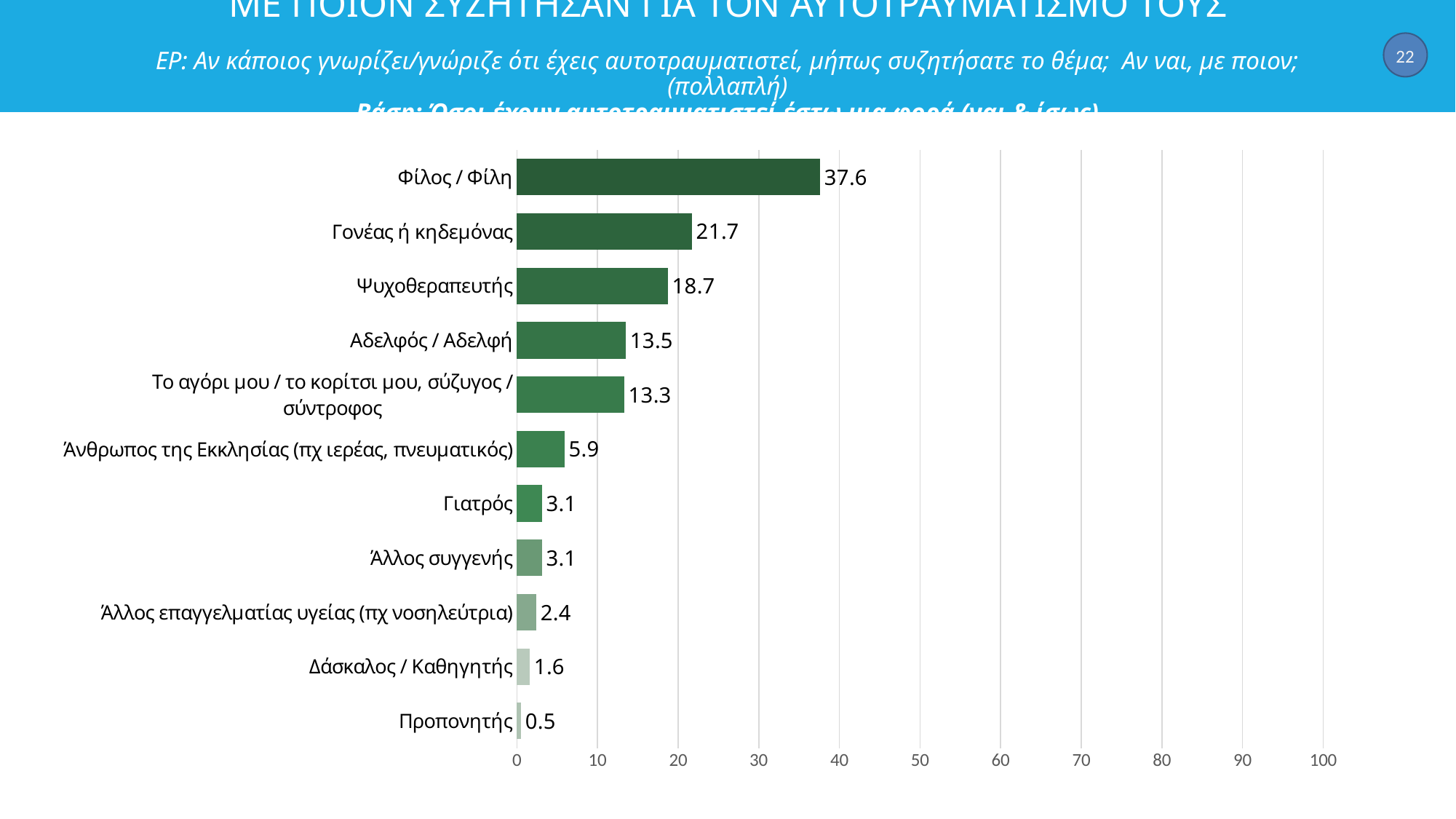
Which category has the lowest value? Προπονητής What is the value for Ψυχοθεραπευτής? 18.7 Which is larger, the value for Αδελφός / Αδελφή or the value for Γιατρός? Αδελφός / Αδελφή What is the value for Φίλος / Φίλη? 37.6 What is the highest value shown on the x axis? 100 What is the value for Δάσκαλος / Καθηγητής? 1.6 What kind of chart is shown on the slide? bar chart Is the value for Γονέας ή κηδεμόνας greater or less than 30? less Which category has the highest value? Φίλος / Φίλη What is the difference between the values for Φίλος / Φίλη and Γονέας ή κηδεμόνας? 15.9 How many categories are shown in the chart? 11 What is the value for Άνθρωπος της Εκκλησίας (πχ ιερέας, πνευματικός)? 5.9